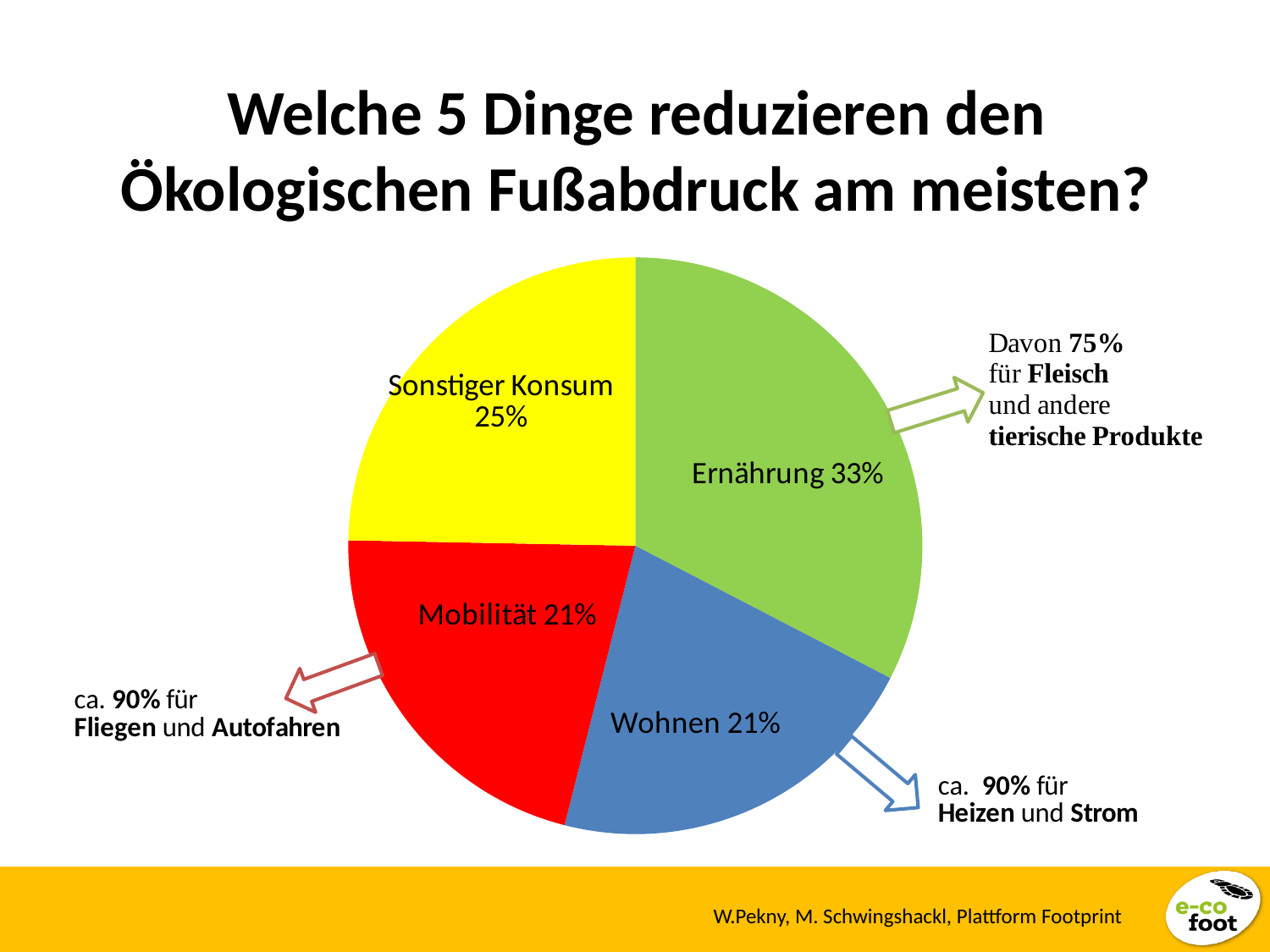
Which is larger, Sonstiger Konsum or Wohnen? Sonstiger Konsum What is the value shown for Sonstiger Konsum? 25% What is the value shown for Wohnen? 21% What colour is the Ernährung slice? green Which category has the largest slice of the pie? Ernährung What kind of chart is shown on the slide? pie chart What colour is the Mobilität slice? red What is the difference in percentage points between Ernährung and Sonstiger Konsum? 8 What share of the pie does Ernährung account for? 33% What is the difference in percentage points between Sonstiger Konsum and Mobilität? 4 How many slices does the pie chart have? 4 What is the value shown for Mobilität? 21%